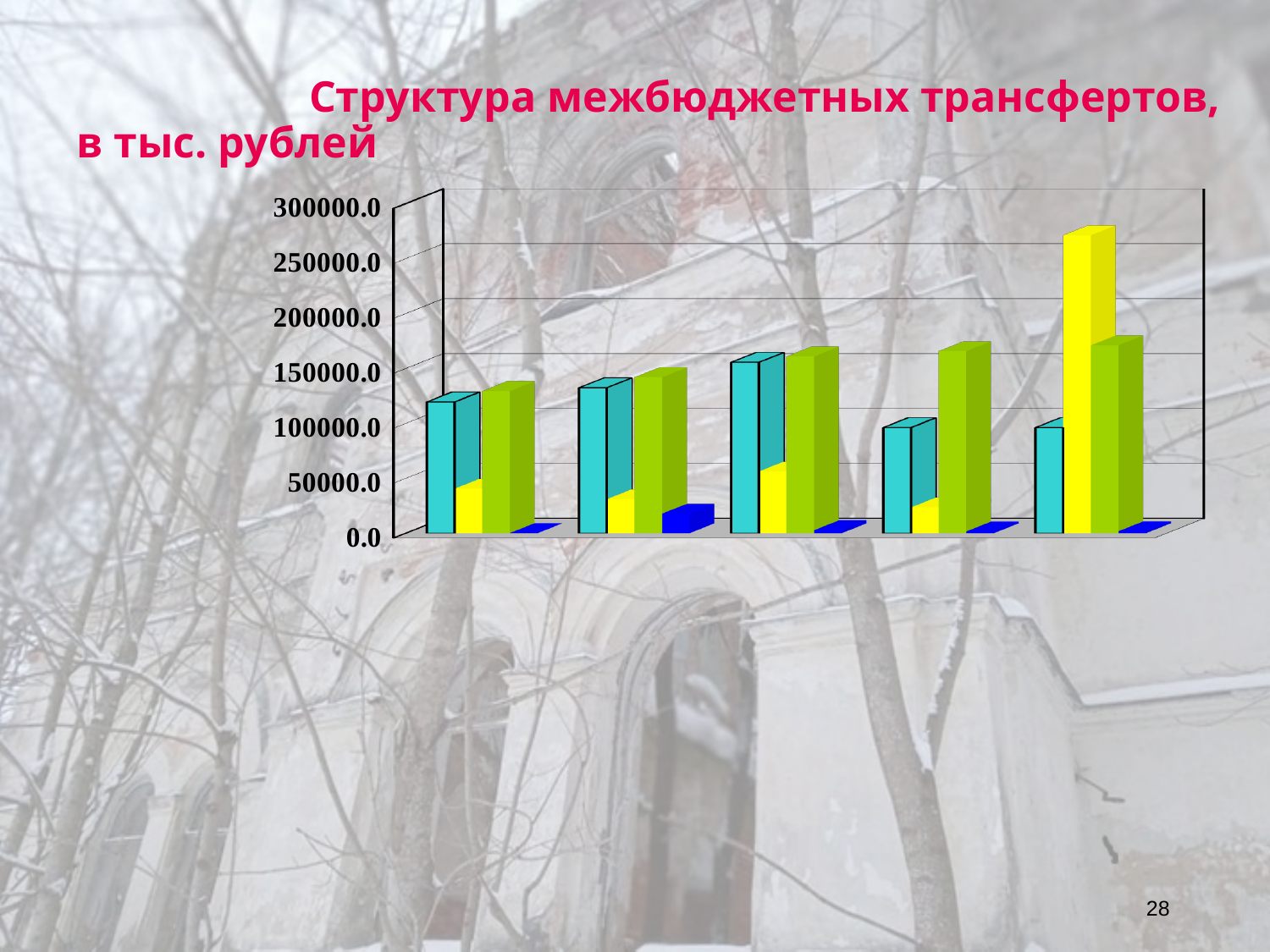
What is the highest value shown on the vertical axis of the chart? 300000.0 What kind of chart is shown on the slide? bar chart Is the value of the cyan bar in the fourth group from the left greater or less than 150000.0? less How many bars are there in each group of the chart? 4 How many groups of bars are plotted in the chart? 5 Is the value of the cyan bar in the leftmost group greater or less than 100000.0? greater What is the title of the chart on the slide? Структура межбюджетных трансфертов, в тыс. рублей In the rightmost group, which bar is taller: the yellow bar or the green bar? the yellow bar Which group of bars contains the tallest bar in the chart? the rightmost (fifth) group Is the value of the green bar in the third group from the left greater or less than 100000.0? greater